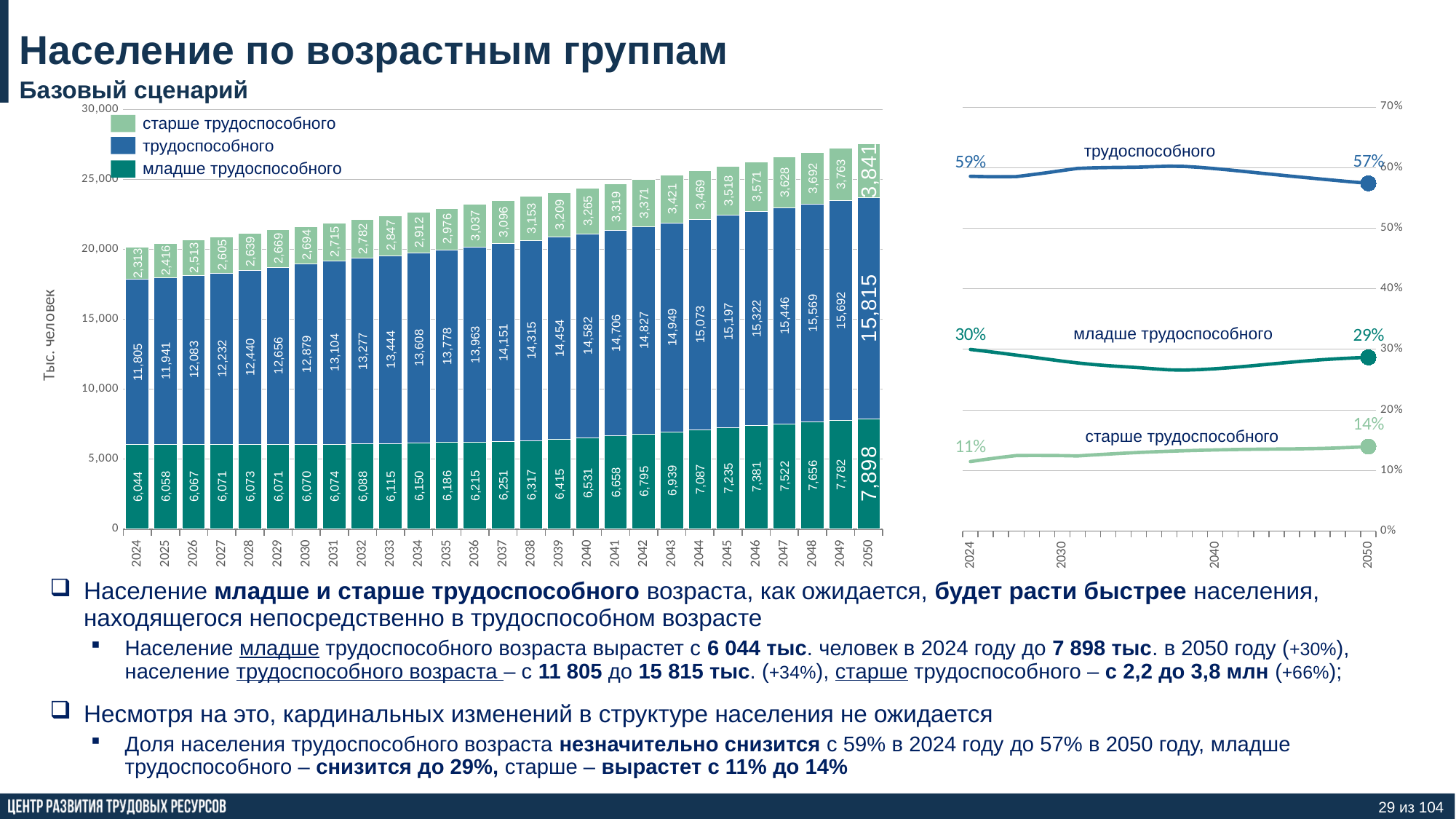
In the left stacked bar chart, how many years are shown on the x axis? 27 In the left stacked bar chart, what is the value for младше трудоспособного in 2050? 7,898 How many series does the legend of the left chart list? 3 In the right line chart, what is the share for трудоспособного in 2050? 57% In the left stacked bar chart, what is the value for трудоспособного in 2024? 11,805 In the left stacked bar chart, what is the total of the stacked bar for 2050? 27,554 In the left stacked bar chart, what is the value for старше трудоспособного in 2040? 3,265 In the left stacked bar chart, what is the total of the stacked bar for 2024? 20,162 In the left stacked bar chart, does the трудоспособного value rise or fall from 2024 to 2050? Rise In the left stacked bar chart, by how much does the трудоспособного value in 2050 exceed the value in 2024? 4,010 In the right line chart, which series has the highest share across all years? трудоспособного What kind of chart is the left chart? Stacked bar chart